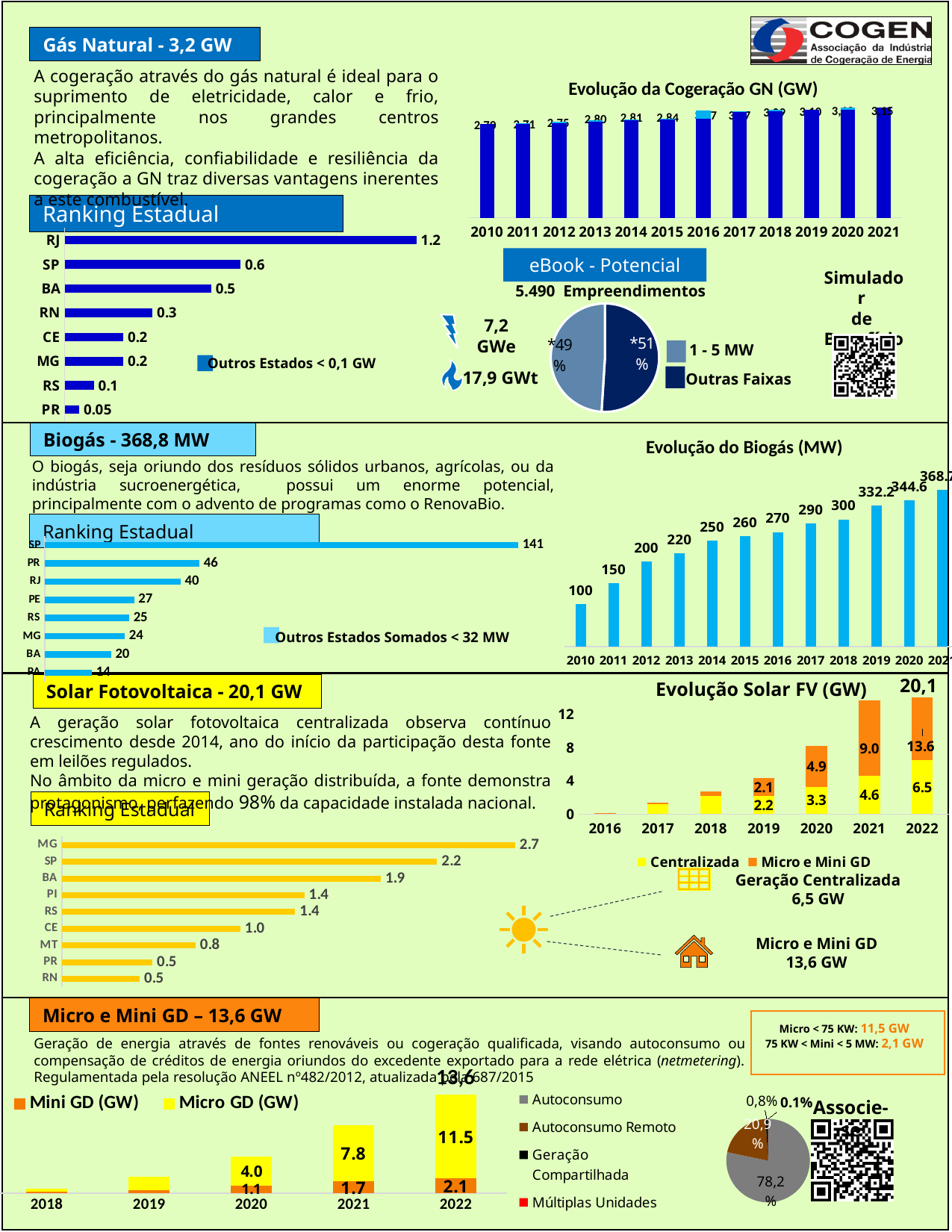
In the 'Evolução do Biogás (MW)' chart, what is the difference between the 2018 and 2010 values? 200 In the 'Evolução do Biogás (MW)' chart, what is the value for 2019? 332.2 In the 'Evolução Solar FV (GW)' chart, what is the Micro e Mini GD value for 2021? 9.0 In the 'Ranking Estadual' bar chart for Biogás, what is the value for PR? 46 In the 'Ranking Estadual' bar chart for Gás Natural, what is the value for RJ? 1.2 In the 'Evolução Solar FV (GW)' chart, what is the total of the stacked bar for 2020? 8.2 In the 'Ranking Estadual' bar chart for Gás Natural, which state has the lowest value? PR In the 'Ranking Estadual' bar chart for Solar Fotovoltaica, which state has the highest value? MG In the pie chart in the Micro e Mini GD section, what share does Autoconsumo have? 78,2% In the Micro e Mini GD stacked bar chart, what is the Micro GD (GW) value for 2022? 11.5 In the 'Evolução da Cogeração GN (GW)' chart, what is the value for 2021? 3.15 In the 'Evolução do Biogás (MW)' chart, do the values rise or fall from 2010 to 2021? rise